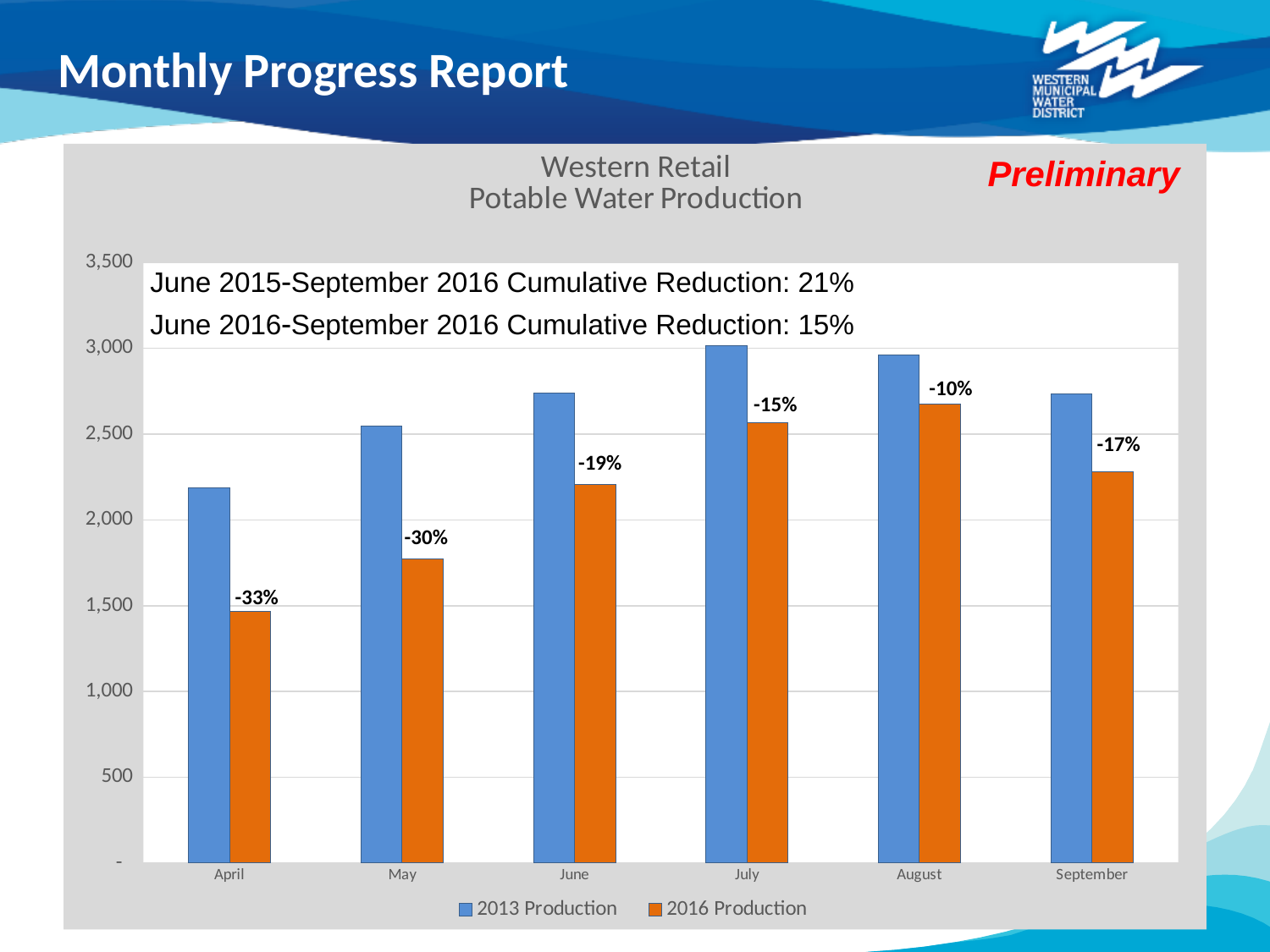
What percentage reduction is labelled for April? -33% Which month has the smallest percentage reduction label? August What is the June 2015-September 2016 cumulative reduction stated on the chart? 21% Which month has the lowest 2013 Production bar? April How many months are shown on the x axis? 6 Which month has the highest 2016 Production bar? August How many series does the legend list? 2 Is the 2013 Production value for July greater or less than 2,500? greater Is the 2016 Production value for May greater or less than 2,000? less In June, which series has the taller bar, 2013 Production or 2016 Production? 2013 Production What kind of chart is shown on the slide? bar chart What percentage reduction is labelled for September? -17%